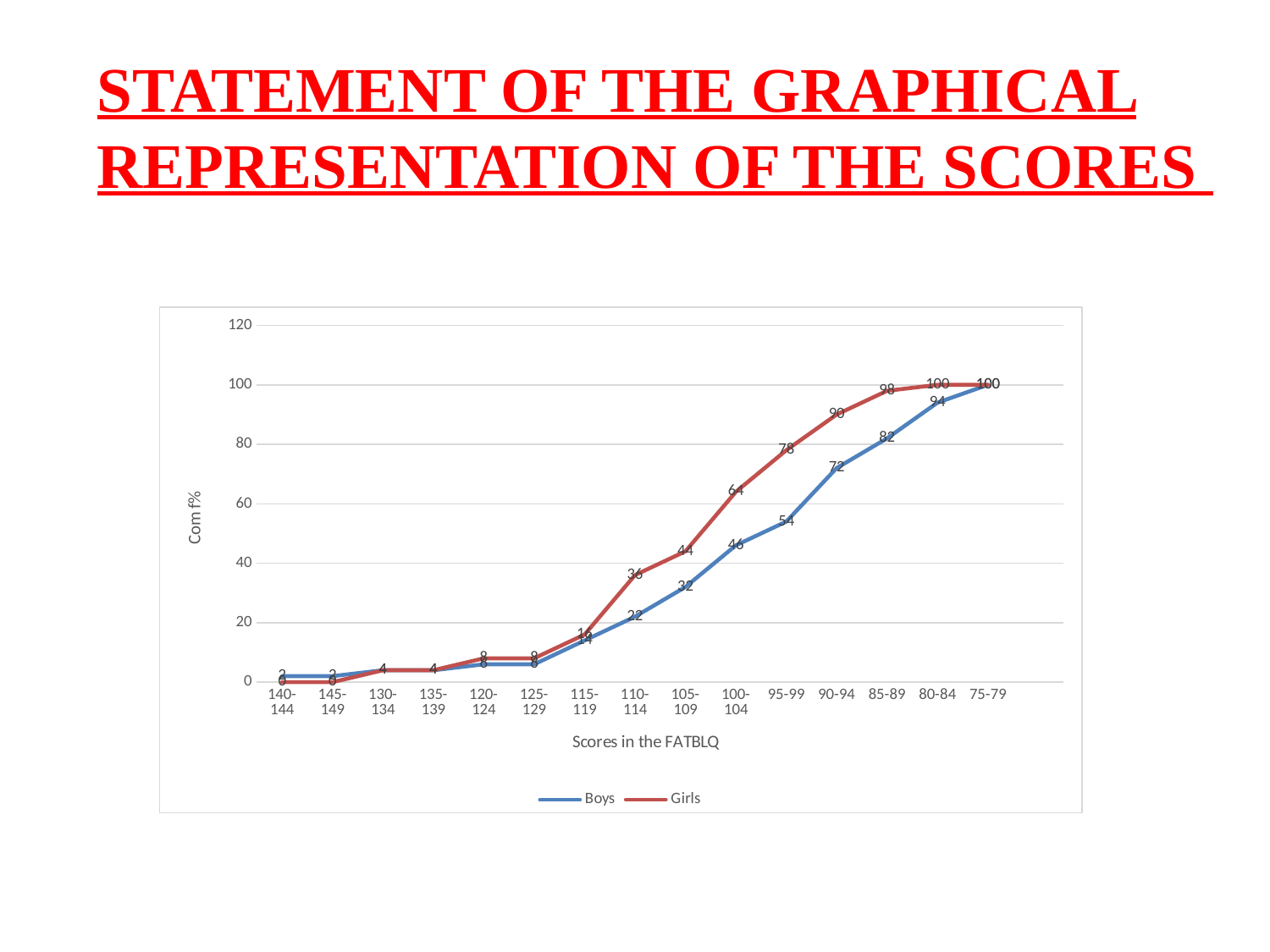
What is the difference between the Girls and Boys values at the 90-94 score range? 18 What is the Boys value for the 90-94 score range? 72 How many score categories are shown on the x axis? 15 What is the Girls value for the 100-104 score range? 64 Do the Boys values rise or fall moving left to right along the x axis? rise At the 95-99 score range, which series has the larger value, Boys or Girls? Girls What is the Boys value for the 85-89 score range? 82 What kind of chart is shown on the slide? line chart What is the Boys value for the 95-99 score range? 54 What is the title of the y axis? Com f% How many series does the legend list? 2 What is the title of the x axis? Scores in the FATBLQ